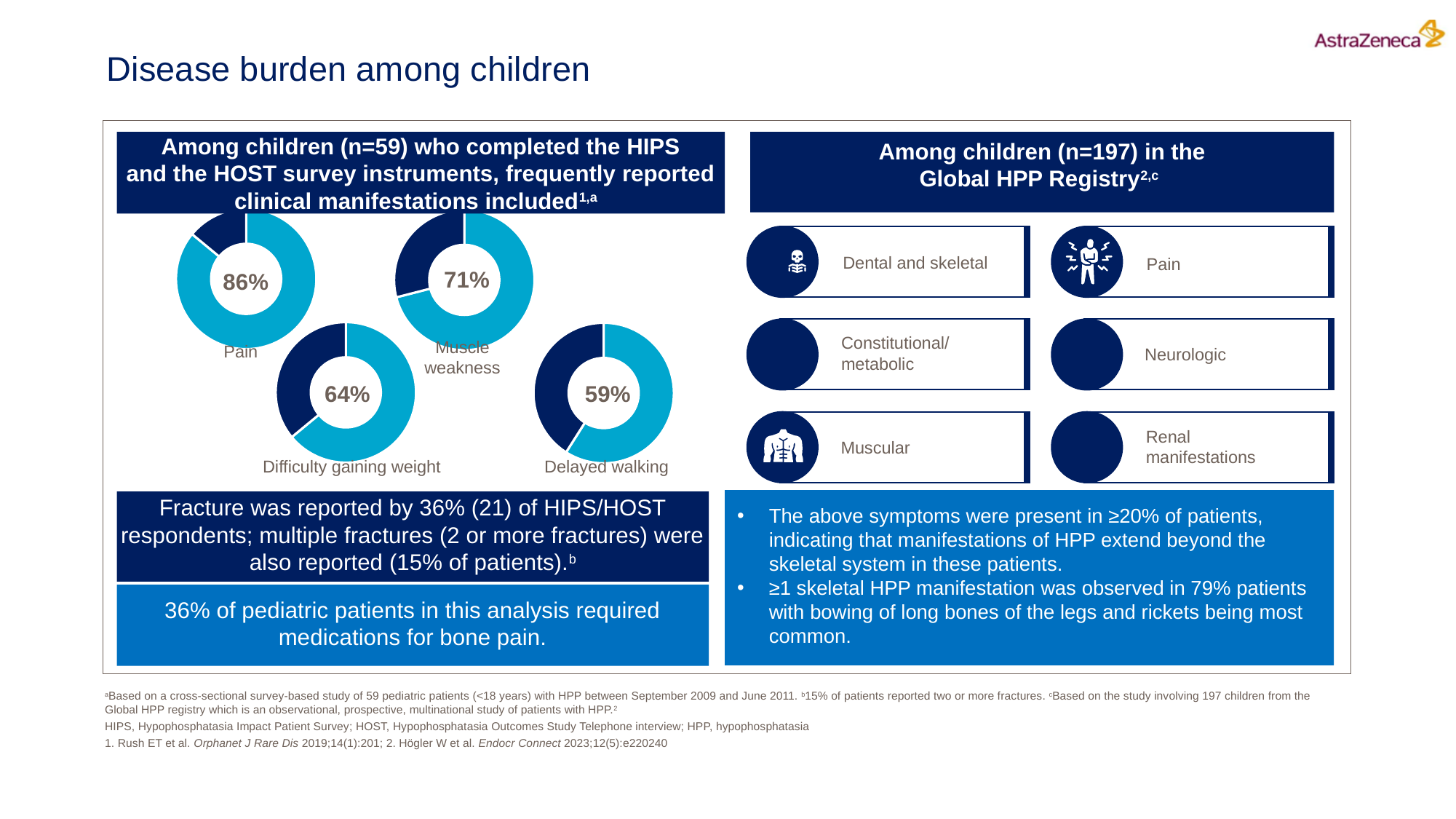
What percentage is shown in the donut chart labelled Muscle weakness? 71% Which is larger, the percentage for Muscle weakness or the percentage for Difficulty gaining weight? Muscle weakness How many donut charts are shown on the slide? 4 What is the difference in percentage points between the Muscle weakness donut chart and the Difficulty gaining weight donut chart? 7 What percentage is shown in the donut chart labelled Difficulty gaining weight? 64% Among the four donut charts, which clinical manifestation has the highest percentage? Pain What percentage is shown in the donut chart labelled Delayed walking? 59% Among the four donut charts, which clinical manifestation has the lowest percentage? Delayed walking What colour is the filled (highlighted) portion of the donut charts? Light blue What is the difference in percentage points between the Pain donut chart and the Delayed walking donut chart? 27 What percentage is shown in the donut chart labelled Pain? 86% What type of chart is used to show the percentage for Pain? Donut chart